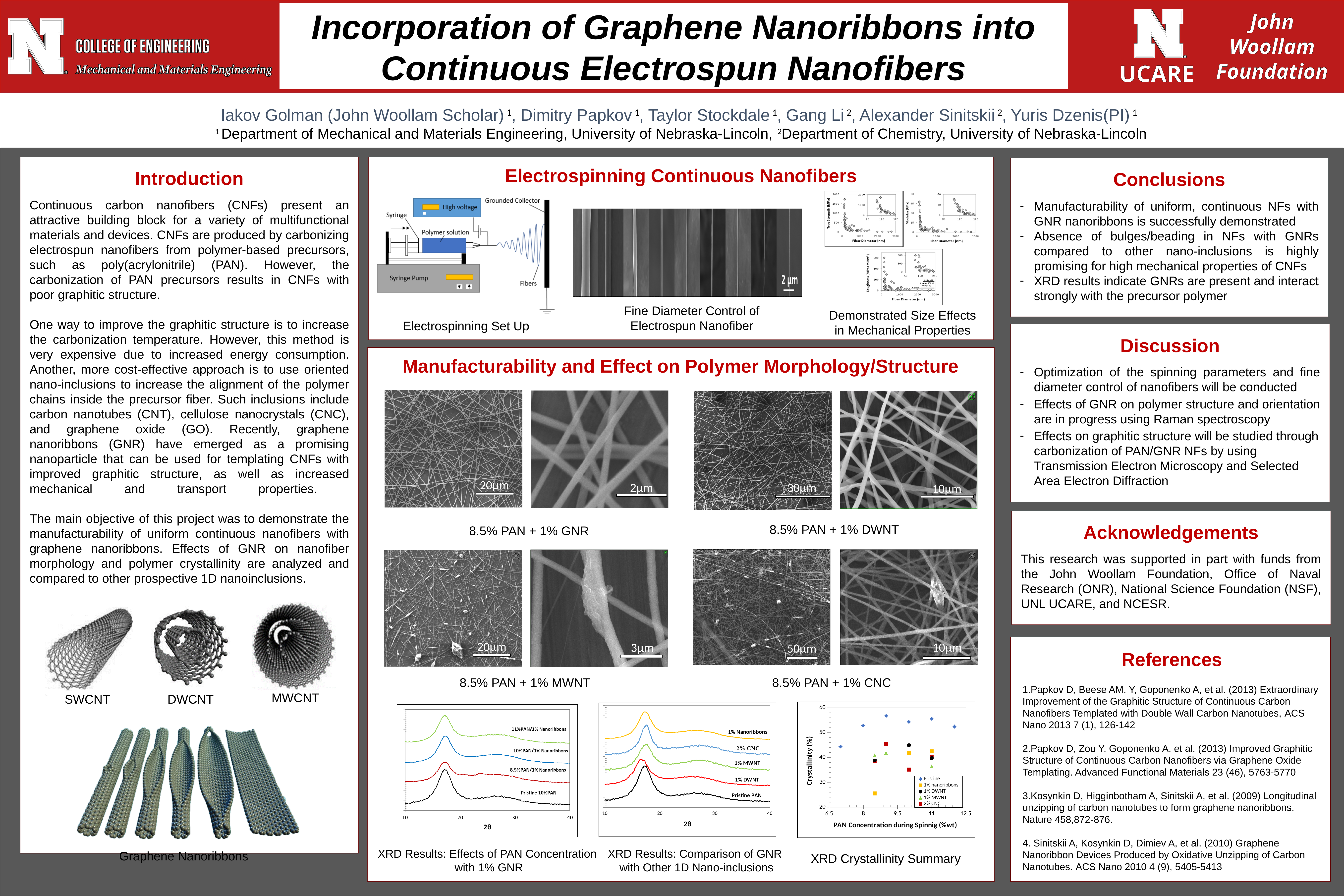
Which curve is at the top of the 'XRD Results: Effects of PAN Concentration with 1% GNR' chart? 11%PAN/1% Nanoribbons What is the x-axis label of the 'XRD Crystallinity Summary' chart? PAN Concentration during Spinnig (%wt) In the 'XRD Crystallinity Summary' chart, is the highest Pristine point greater or less than 50? greater In the 'XRD Crystallinity Summary' chart, which series has the highest crystallinity values? Pristine How many series does the legend of the 'XRD Crystallinity Summary' chart list? 5 How many curves are plotted in the 'XRD Results: Comparison of GNR with Other 1D Nano-inclusions' chart? 5 In the 'XRD Crystallinity Summary' chart, is the Pristine point at the lowest PAN concentration greater or less than 50? less In the 'XRD Crystallinity Summary' chart, is the lowest 1% nanoribbons point greater or less than 30? less What kind of chart is 'XRD Results: Comparison of GNR with Other 1D Nano-inclusions'? line chart What kind of chart is the 'XRD Crystallinity Summary'? scatter chart How many curves are plotted in the 'XRD Results: Effects of PAN Concentration with 1% GNR' chart? 4 What is the y-axis label of the 'XRD Crystallinity Summary' chart? Crystallinity (%)